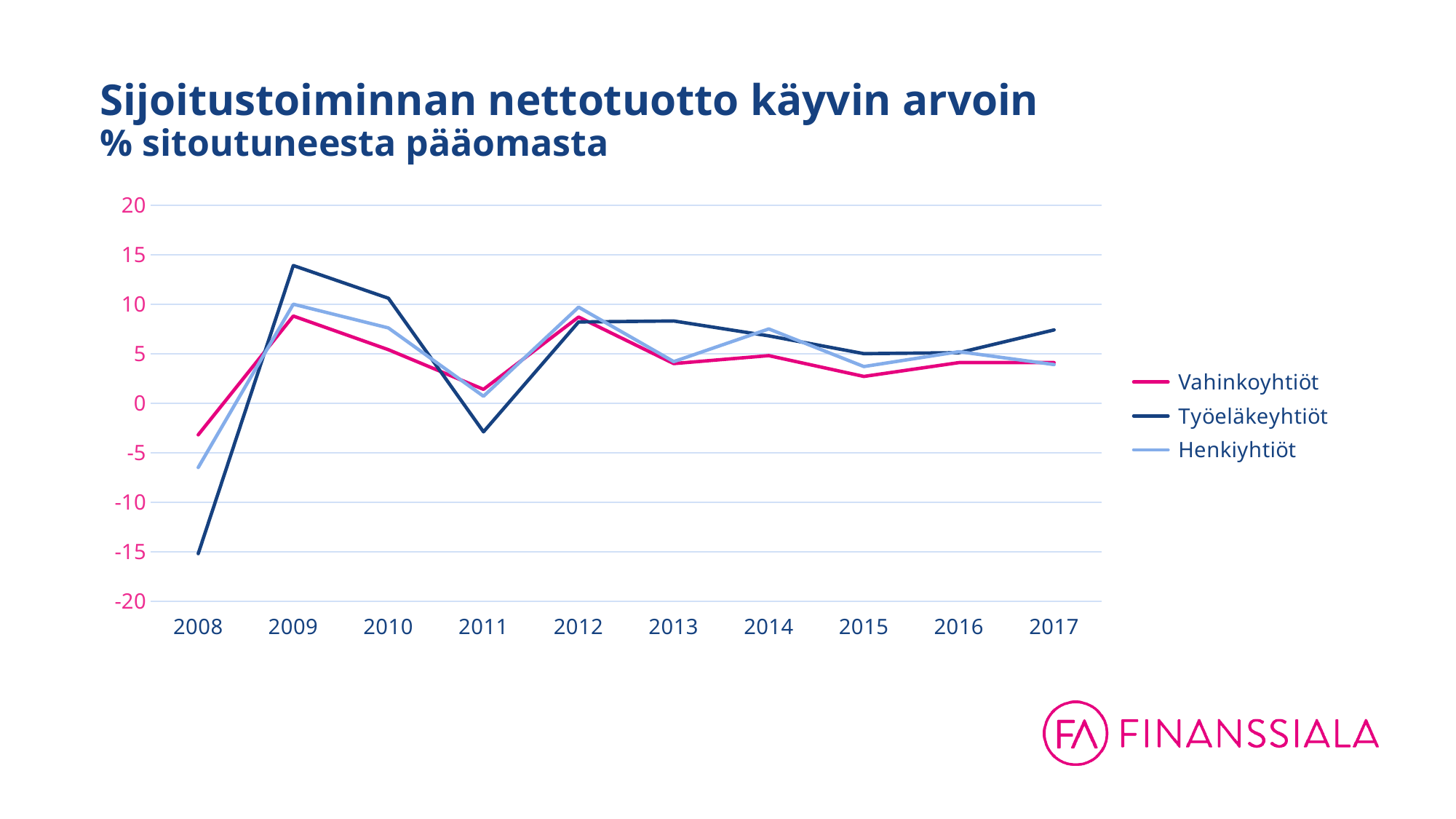
Is the value for Vahinkoyhtiöt in 2015 greater or less than 5? less In 2008, which is larger: the value for Vahinkoyhtiöt or the value for Työeläkeyhtiöt? Vahinkoyhtiöt Is the value for Työeläkeyhtiöt in 2009 greater or less than 10? greater Is the value for Työeläkeyhtiöt in 2011 greater or less than 0? less How many series does the legend list? 3 How many years are plotted along the x axis? 10 In which year is the value for Työeläkeyhtiöt lowest? 2008 Does the value for Vahinkoyhtiöt rise or fall from 2009 to 2011? fall In which year is the value for Työeläkeyhtiöt highest? 2009 What kind of chart is shown on the slide? line chart What is the title of the chart? Sijoitustoiminnan nettotuotto käyvin arvoin % sitoutuneesta pääomasta In which year is the value for Henkiyhtiöt lowest? 2008